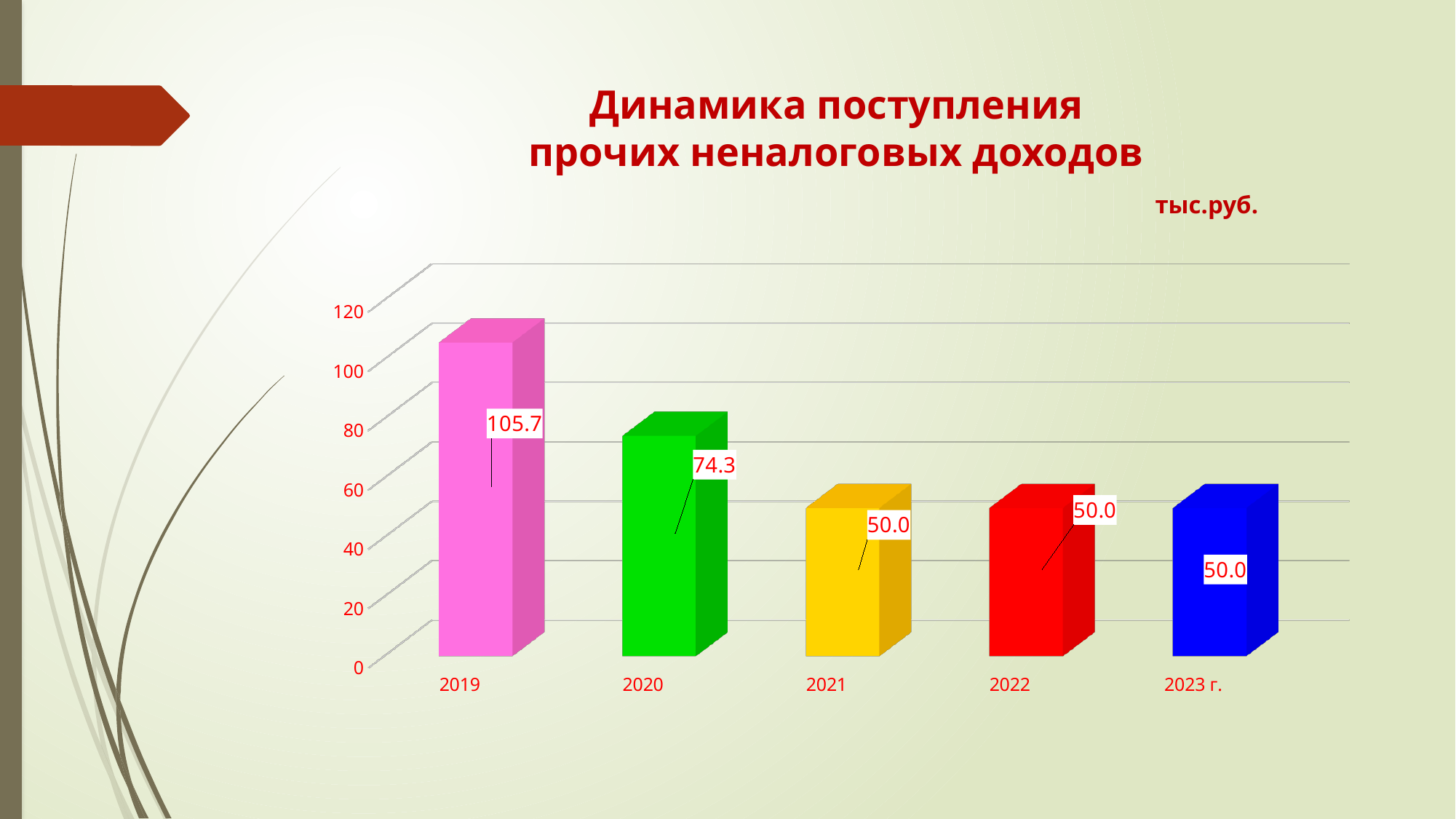
What kind of chart is shown on the slide? bar chart What is the difference between the values for 2019 and 2020? 31.4 What is the value for 2020? 74.3 What is the value for 2019? 105.7 How many years are shown on the x axis? 5 What is the value for 2021? 50.0 What unit is indicated for the values on the chart? тыс.руб. What is the difference between the values for 2020 and 2022? 24.3 Is the value for 2020 greater or less than 60? greater Which is larger, the value for 2019 or the value for 2021? 2019 Which year has the highest value? 2019 What is the value for 2023 г.? 50.0